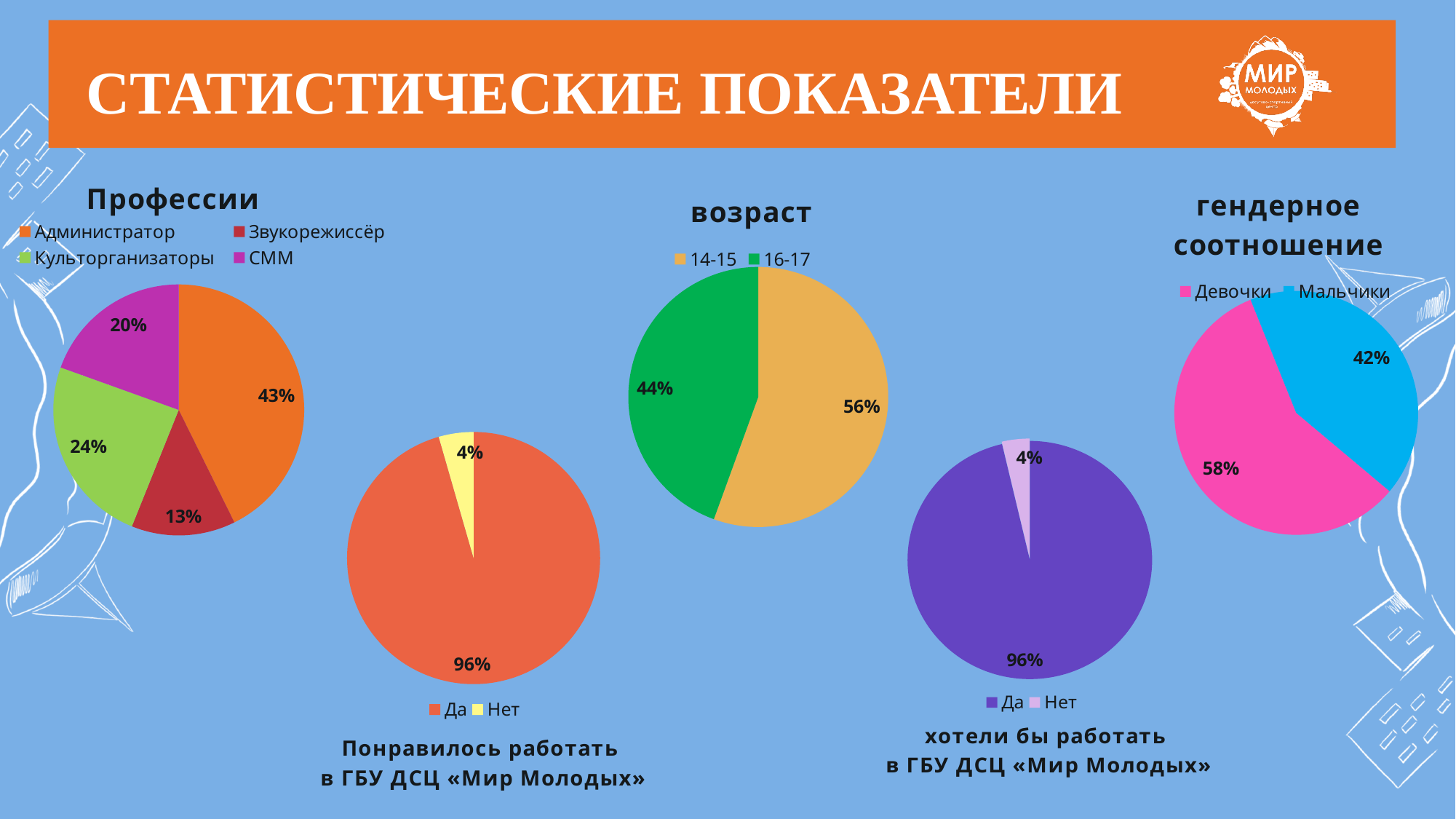
In the "гендерное соотношение" chart, what is the difference between the shares for Девочки and Мальчики? 16% In the "Профессии" chart, which category has the largest slice? Администратор In the "возраст" chart, which group is larger, 14-15 or 16-17? 14-15 How many categories does the "Профессии" chart show? 4 In the "Профессии" chart, which category has the smallest slice? Звукорежиссёр In the "возраст" chart, what share is labelled for the 16-17 group? 44% In the "Понравилось работать в ГБУ ДСЦ «Мир Молодых»" chart, what share is labelled for Нет? 4% What type of chart is the "хотели бы работать в ГБУ ДСЦ «Мир Молодых»" chart? pie chart In the "Профессии" chart, what share is labelled for Звукорежиссёр? 13% In the "Профессии" chart, what share is labelled for Администратор? 43% In the "Профессии" chart, what is the difference between the shares for Культорганизаторы and СММ? 4% In the "гендерное соотношение" chart, what share is labelled for Девочки? 58%